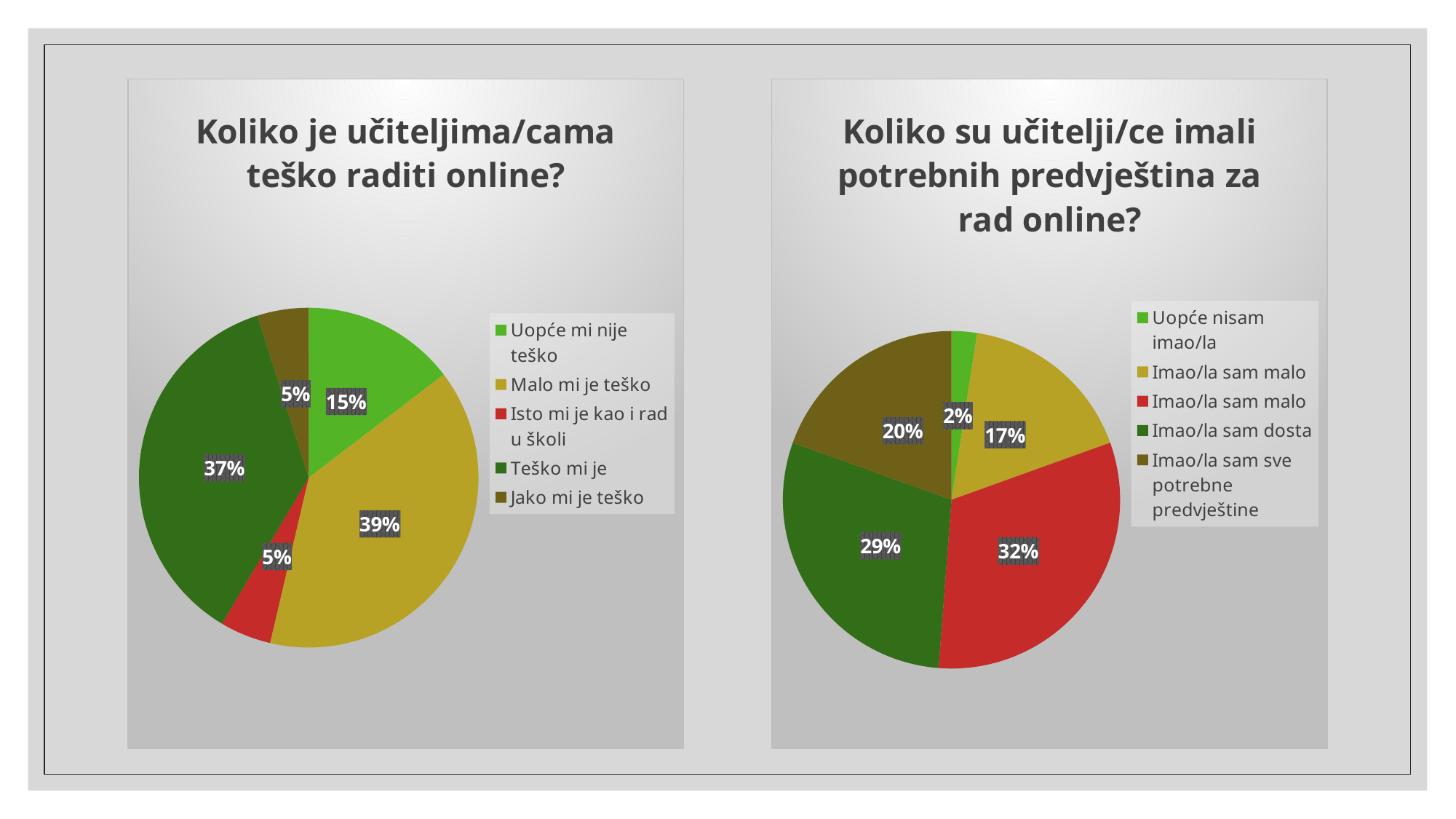
In the left chart, what is the difference in percentage points between 'Malo mi je teško' and 'Teško mi je'? 2 In the left chart, which is larger: 'Uopće mi nije teško' or 'Jako mi je teško'? Uopće mi nije teško In the left chart, 'Koliko je učiteljima/cama teško raditi online?', what percentage is shown for 'Malo mi je teško'? 39% In the right chart, what is the difference in percentage points between 'Imao/la sam dosta' and 'Imao/la sam sve potrebne predvještine'? 9 In the right chart, what percentage is shown for 'Imao/la sam dosta'? 29% In the right chart, which category has the smallest share of the pie? Uopće nisam imao/la In the left chart, which category has the largest share of the pie? Malo mi je teško In the left chart, what percentage is shown for 'Uopće mi nije teško'? 15% In the right chart, 'Koliko su učitelji/ce imali potrebnih predvještina za rad online?', what percentage is shown for 'Uopće nisam imao/la'? 2% How many slices does the left pie chart have? 5 How many entries does the legend of the right chart list? 5 What type of chart is used on the left side of the slide? Pie chart